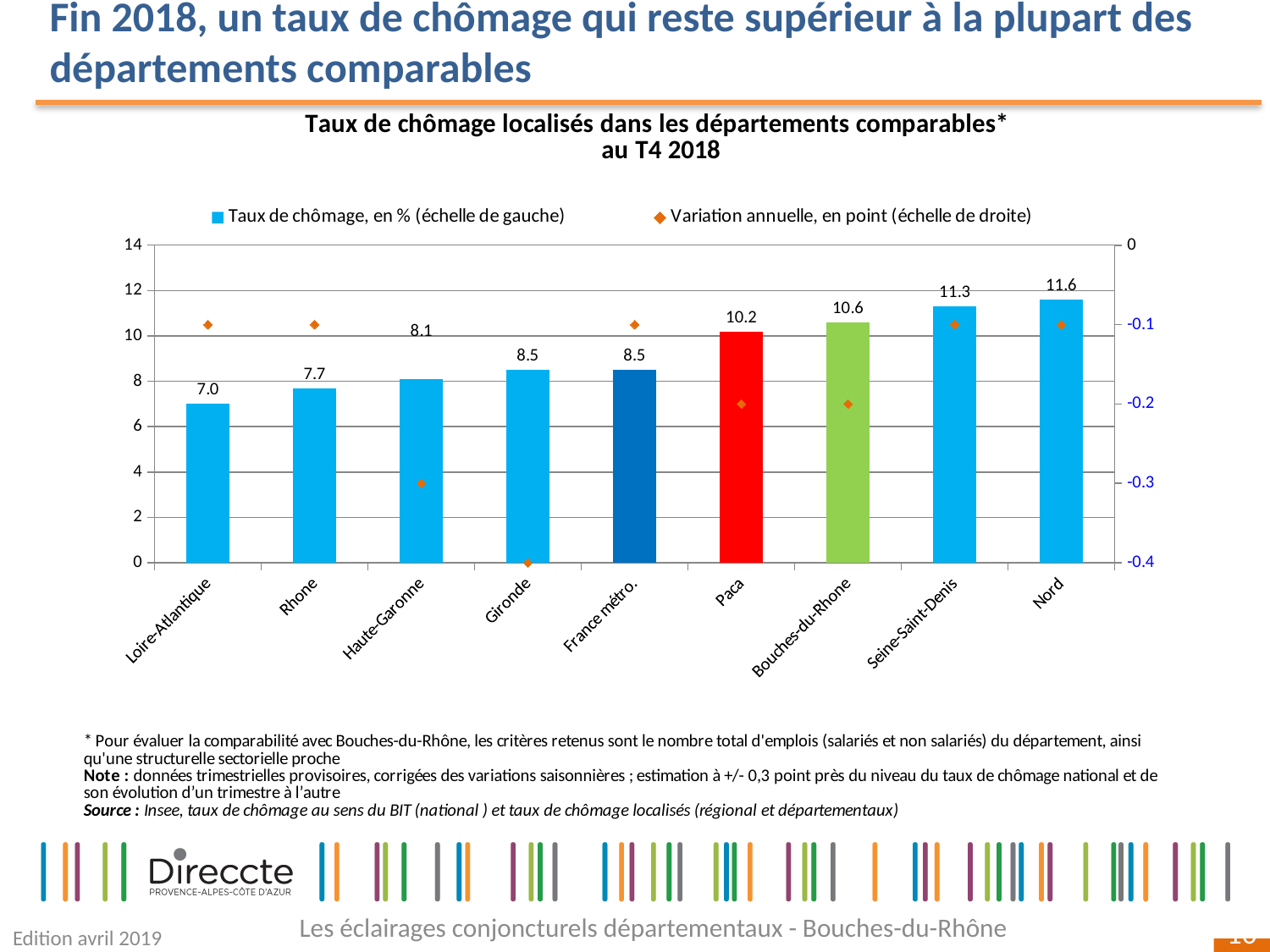
Which has a higher unemployment rate, Paca or Seine-Saint-Denis? Seine-Saint-Denis Which department has the highest unemployment rate in the chart? Nord What is the difference between the unemployment rates of Nord and Loire-Atlantique? 4.6 What is the unemployment rate shown for Loire-Atlantique? 7.0 What is the unemployment rate shown for France métro.? 8.5 How many series does the chart legend list? 2 Do the unemployment rate bars rise or fall from left to right along the x axis? Rise Is the annual variation (Variation annuelle) for Gironde greater or less than -0.3? less What type of chart is used to show the unemployment rates? Bar chart Which department has the lowest unemployment rate in the chart? Loire-Atlantique What is the unemployment rate (Taux de chômage) shown for Bouches-du-Rhone? 10.6 How many departments/areas are shown on the x axis of the chart? 9